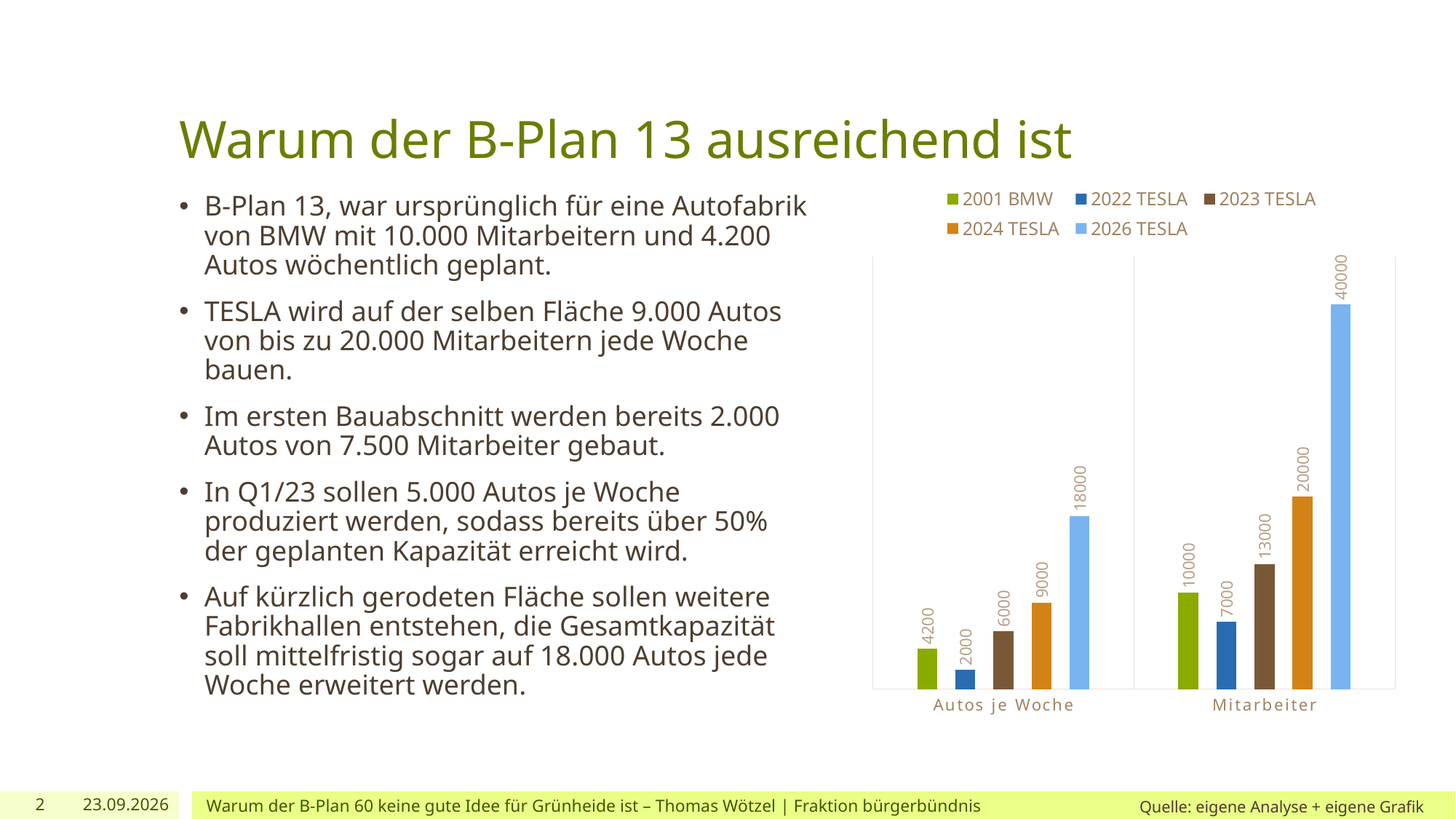
What is the value for 2026 TESLA in the Mitarbeiter category? 40000 How many categories are shown on the x axis? 2 What is the value for 2023 TESLA in the Autos je Woche category? 6000 Which is larger in the Mitarbeiter category: 2001 BMW or 2022 TESLA? 2001 BMW What is the difference between the 2024 TESLA and 2023 TESLA values in the Mitarbeiter category? 7000 What is the value for 2001 BMW in the Autos je Woche category? 4200 Which series has the lowest value in the Autos je Woche category? 2022 TESLA What is the difference between the 2026 TESLA and 2001 BMW values in the Autos je Woche category? 13800 What kind of chart is shown on the slide? Bar chart How many series does the legend list? 5 What is the value for 2024 TESLA in the Mitarbeiter category? 20000 Which series has the highest value in the Mitarbeiter category? 2026 TESLA